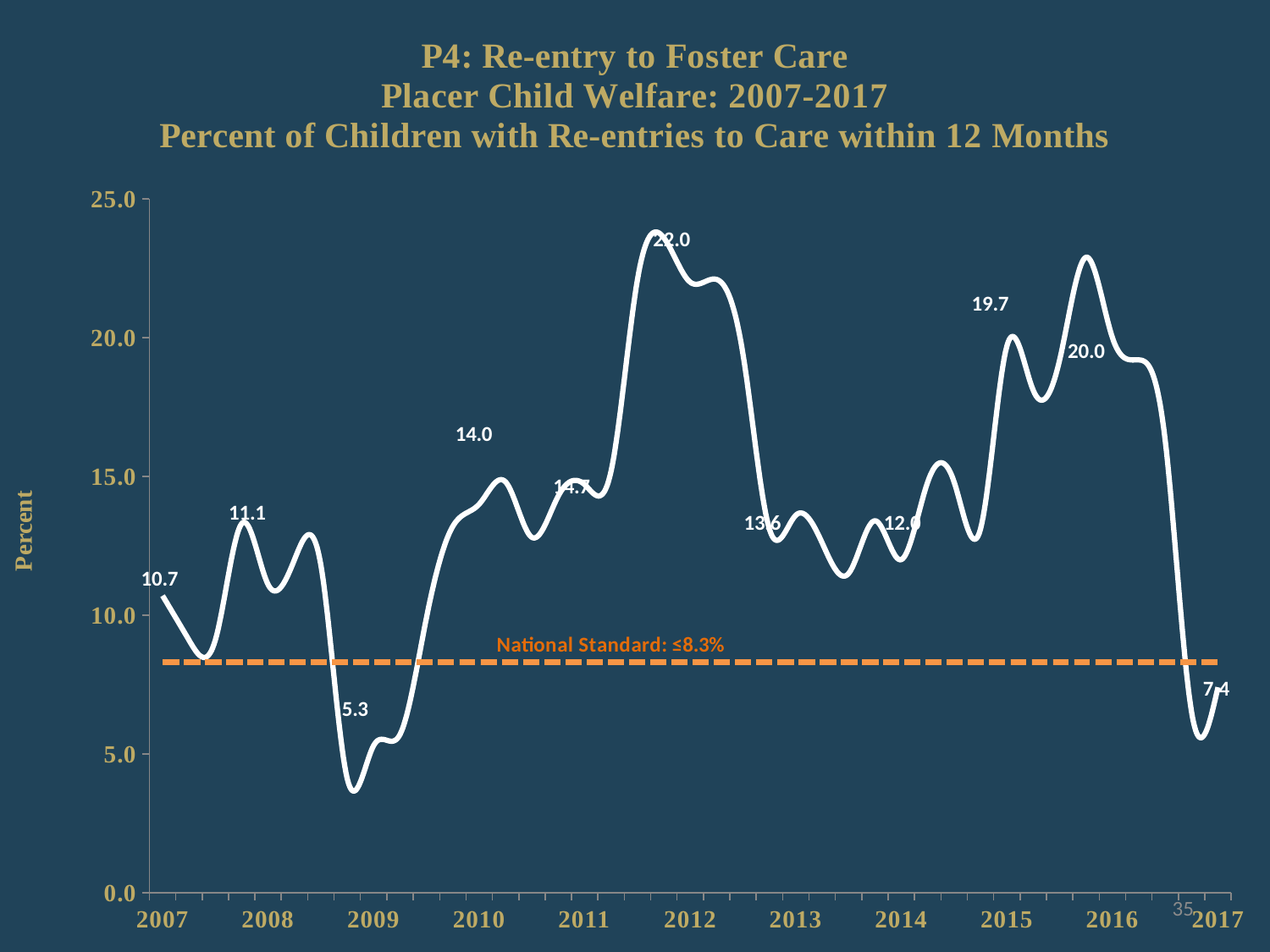
What national standard is shown by the dashed line? ≤8.3% What is the value labelled for 2009? 5.3 Which year has the highest re-entry percentage? 2012 What type of chart is shown on the slide? line chart What is the percent of children with re-entries to care for 2007? 10.7 How many years are labelled on the x axis? 11 What is the value labelled for 2015? 19.7 Which year has the larger value, 2010 or 2009? 2010 What is the difference between the 2016 value (20.0) and the 2015 value (19.7)? 0.3 Is the value for 2013 greater or less than 15.0? less What is the value labelled for 2017? 7.4 Which year has the lowest re-entry percentage? 2009